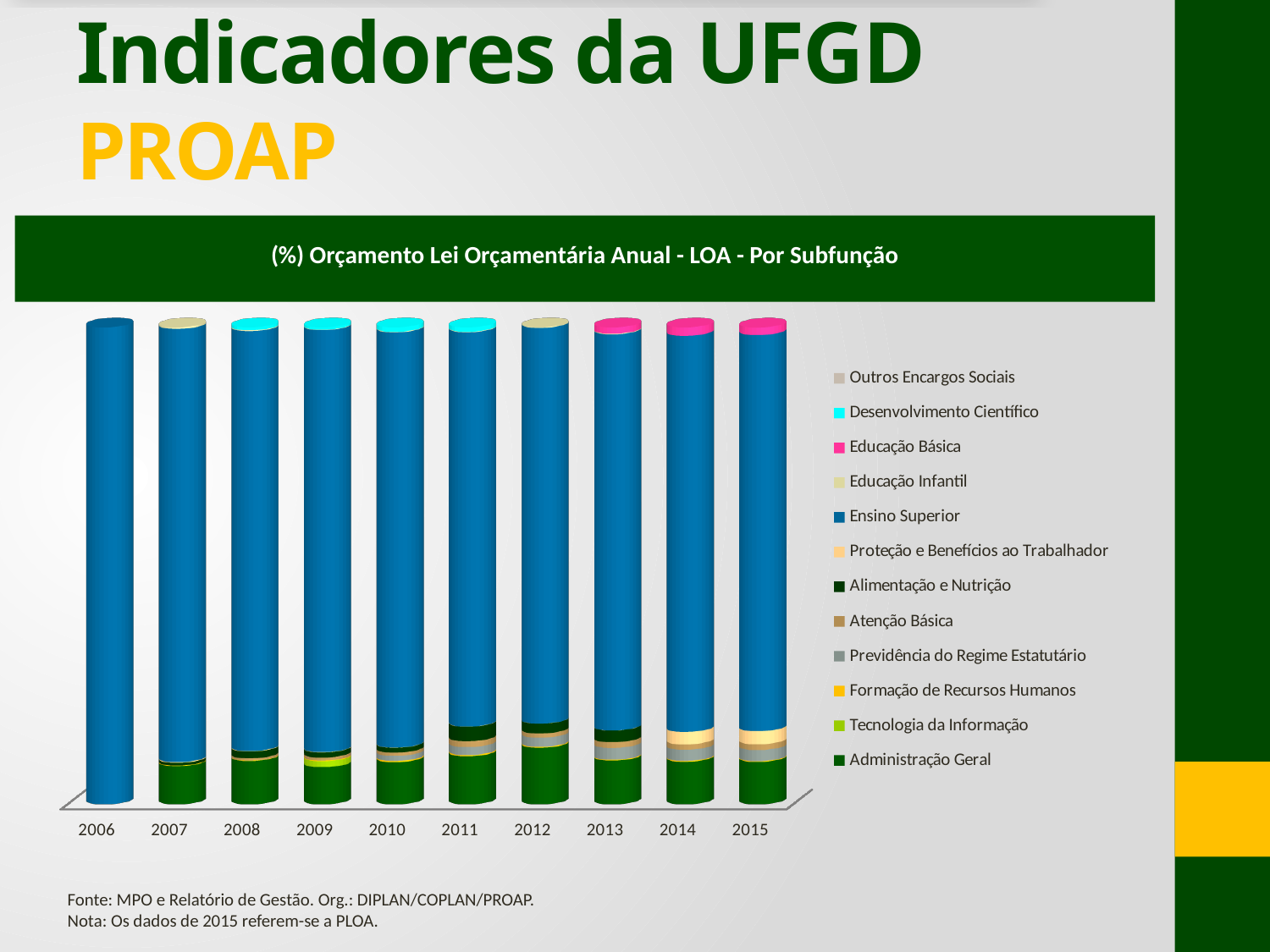
Which year is the last category on the x axis? 2015 What kind of chart is shown on the slide? Stacked bar chart Which series is listed last in the chart legend? Administração Geral Which series is listed first in the chart legend? Outros Encargos Sociais What is the title of the chart? (%) Orçamento Lei Orçamentária Anual - LOA - Por Subfunção How many years are shown on the x axis of the chart? 10 How many series does the chart legend list? 12 Is the share of Ensino Superior in 2015 larger or smaller than the share of Administração Geral in 2015? Larger Which series takes up the largest share of every bar in the chart? Ensino Superior